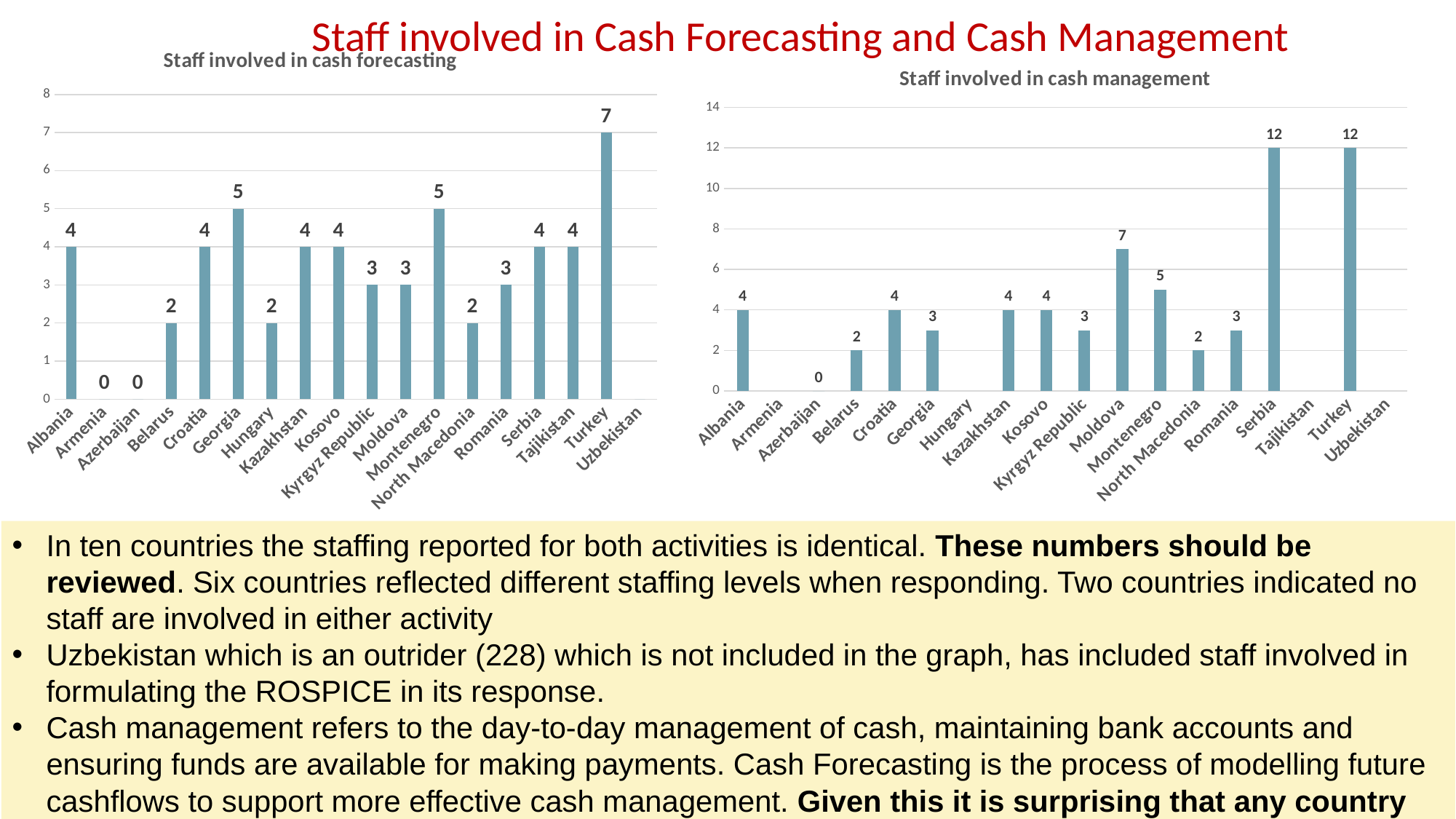
In the 'Staff involved in cash forecasting' chart, what is the value for Georgia? 5 In the 'Staff involved in cash management' chart, what is the value for Montenegro? 5 In the 'Staff involved in cash management' chart, what is the value for Moldova? 7 What is the title of the chart on the left of the slide? Staff involved in cash forecasting In the 'Staff involved in cash management' chart, what is the difference between the values for Serbia and Moldova? 5 In the 'Staff involved in cash forecasting' chart, what is the value for Turkey? 7 How many countries are listed on the x axis of the 'Staff involved in cash forecasting' chart? 18 In the 'Staff involved in cash management' chart, which is larger, the value for Moldova or the value for Georgia? Moldova In the 'Staff involved in cash forecasting' chart, what is the difference between the values for Turkey and Georgia? 2 In the 'Staff involved in cash management' chart, is the value for Serbia greater or less than 10? greater In the 'Staff involved in cash forecasting' chart, which country has the highest value? Turkey What kind of chart is the 'Staff involved in cash management' chart? bar chart